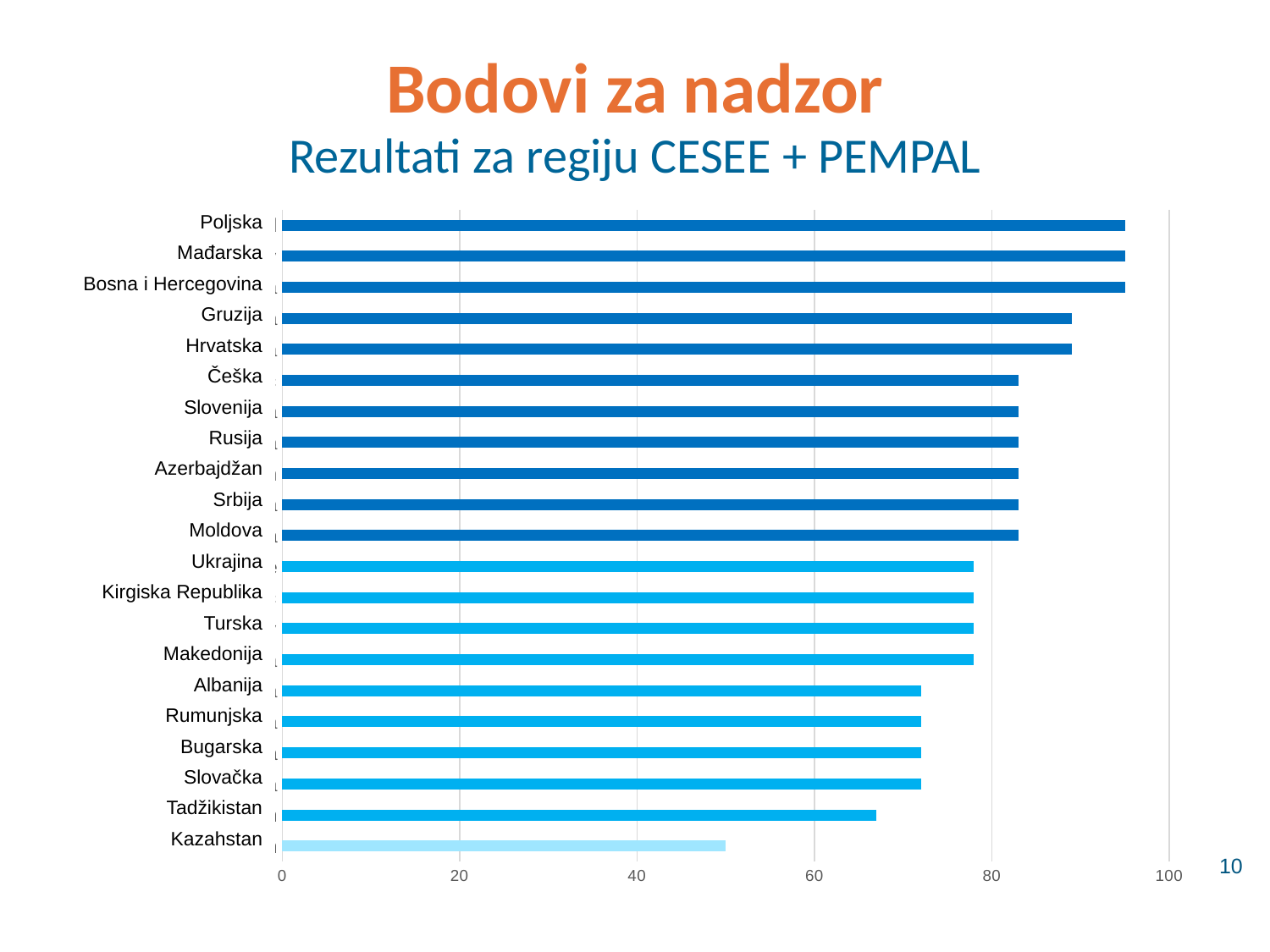
Is the value for Albanija greater or less than 80? less How many countries are listed on the chart? 21 Is the value for Tadžikistan greater or less than 60? greater What is the main title of the slide above the chart? Bodovi za nadzor Is the value for Poljska greater or less than 80? greater Which country has the lowest value on the chart? Kazahstan Which has a larger value, Kazahstan or Turska? Turska Do the bar values increase or decrease going from the top of the chart to the bottom? decrease What kind of chart is shown on the slide? bar chart Which has a larger value, Hrvatska or Slovačka? Hrvatska